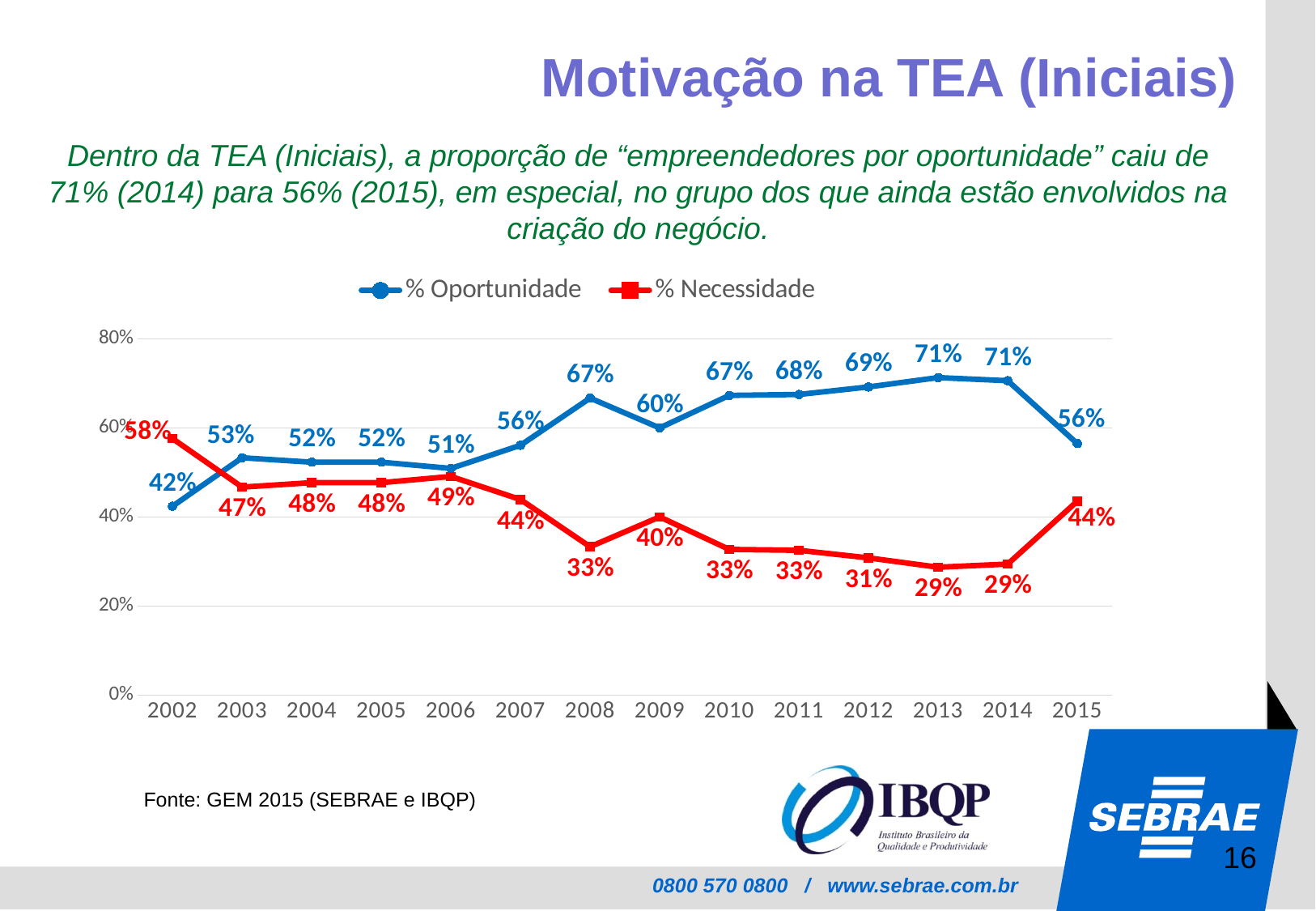
What type of chart is shown on the slide? Line chart Does % Necessidade rise or fall from 2002 to 2014? Fall How many years are shown on the x axis? 14 What is the value of % Oportunidade in 2009? 60% What is the difference between % Oportunidade and % Necessidade in 2014? 42 percentage points How many series does the legend list? 2 What is the value of % Necessidade in 2002? 58% In which year is % Oportunidade at its lowest value? 2002 In which year is % Necessidade at its lowest value? 2013 and 2014 What colour is the % Necessidade line? Red What is the value of % Oportunidade in 2015? 56% Which series has the higher value in 2002, % Oportunidade or % Necessidade? % Necessidade